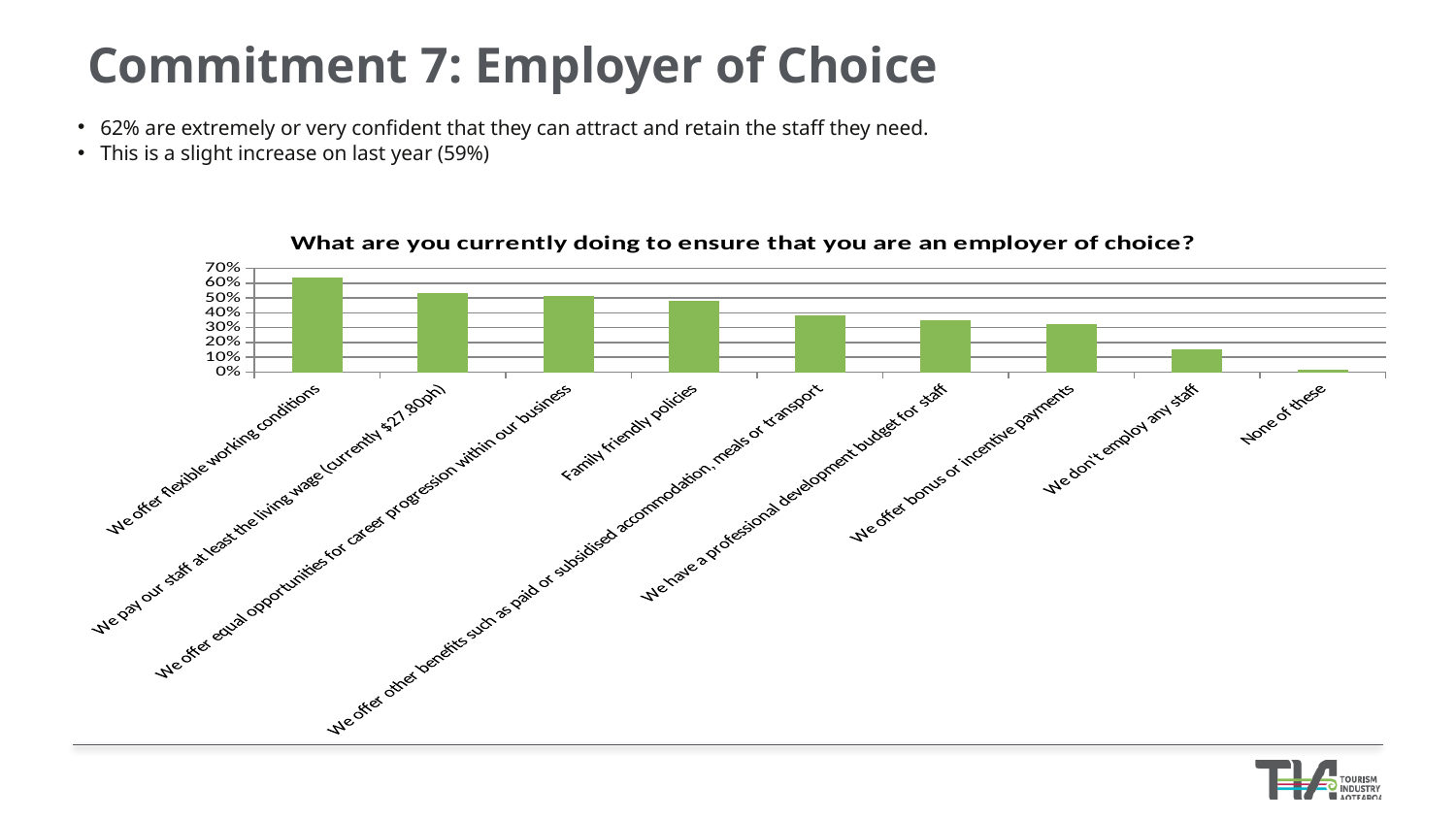
How many categories are shown on the x axis of the chart? 9 Is the value for 'None of these' greater or less than 10%? less Is the value for 'We pay our staff at least the living wage (currently $27.80ph)' greater or less than 40%? greater Is the value for 'We offer flexible working conditions' greater or less than 50%? greater What is the title of the chart? What are you currently doing to ensure that you are an employer of choice? Do the values generally rise or fall moving from left to right along the x axis? fall Which category has the lowest value in the chart? None of these Which category has the highest value in the chart? We offer flexible working conditions What kind of chart is shown on the slide? bar chart Which is larger: the value for 'Family friendly policies' or the value for 'We offer bonus or incentive payments'? Family friendly policies